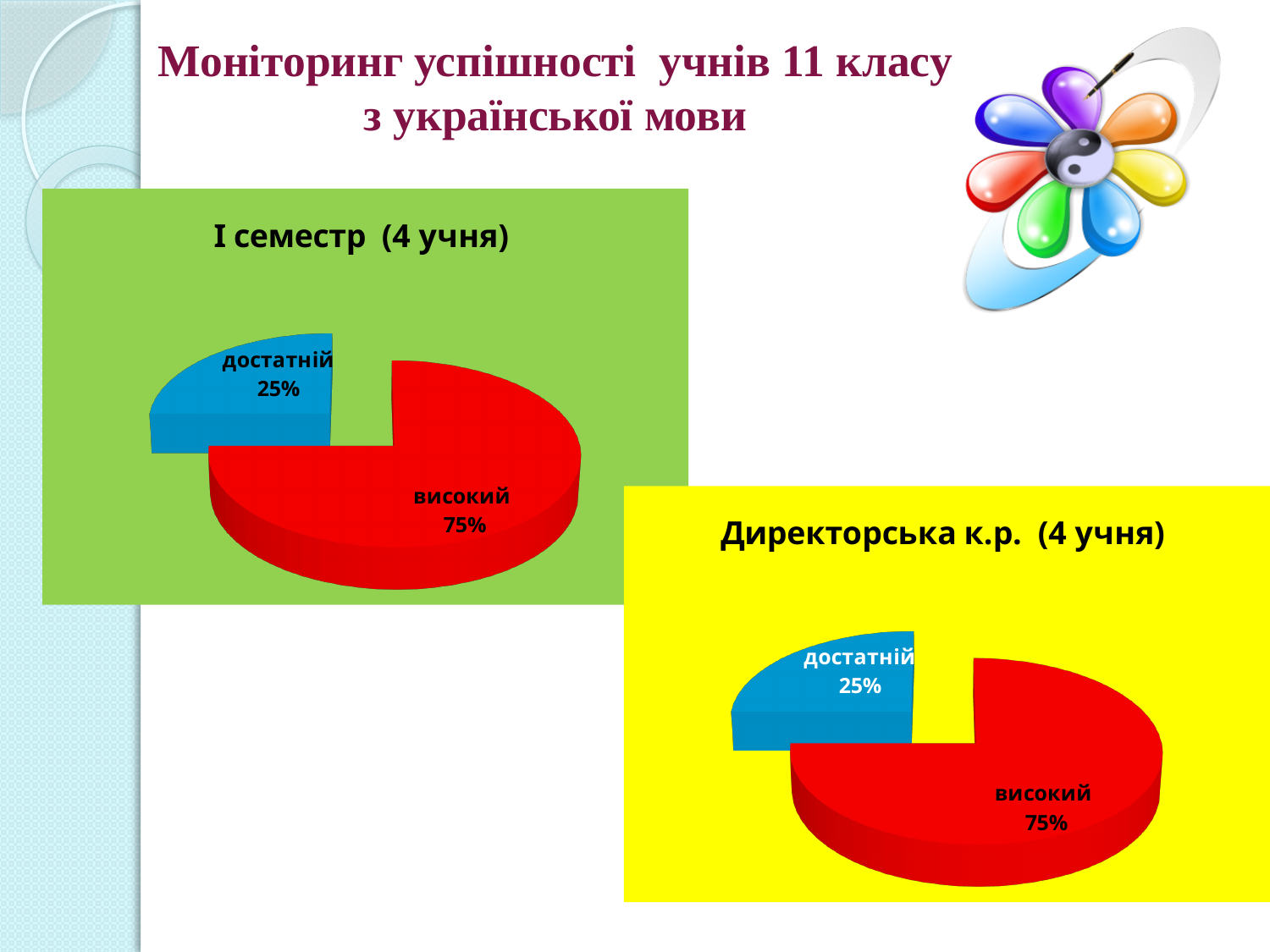
In the 'І семестр (4 учня)' chart, what share does 'високий' have? 75% In the 'І семестр (4 учня)' chart, what is the difference between the 'високий' and 'достатній' shares? 50% In the 'І семестр (4 учня)' chart, what share does 'достатній' have? 25% In the 'Директорська к.р. (4 учня)' chart, what share does 'високий' have? 75% In the 'Директорська к.р. (4 учня)' chart, which category has the smallest slice? достатній In the 'Директорська к.р. (4 учня)' chart, what share does 'достатній' have? 25% What type of chart is the 'Директорська к.р. (4 учня)' chart? pie chart How many slices does the 'І семестр (4 учня)' pie chart have? 2 In the 'І семестр (4 учня)' chart, what colour is the 'високий' slice? red In the 'І семестр (4 учня)' chart, which category has the largest slice? високий What is the title of the chart on the yellow background? Директорська к.р. (4 учня) In the 'Директорська к.р. (4 учня)' chart, which is larger, 'високий' or 'достатній'? високий